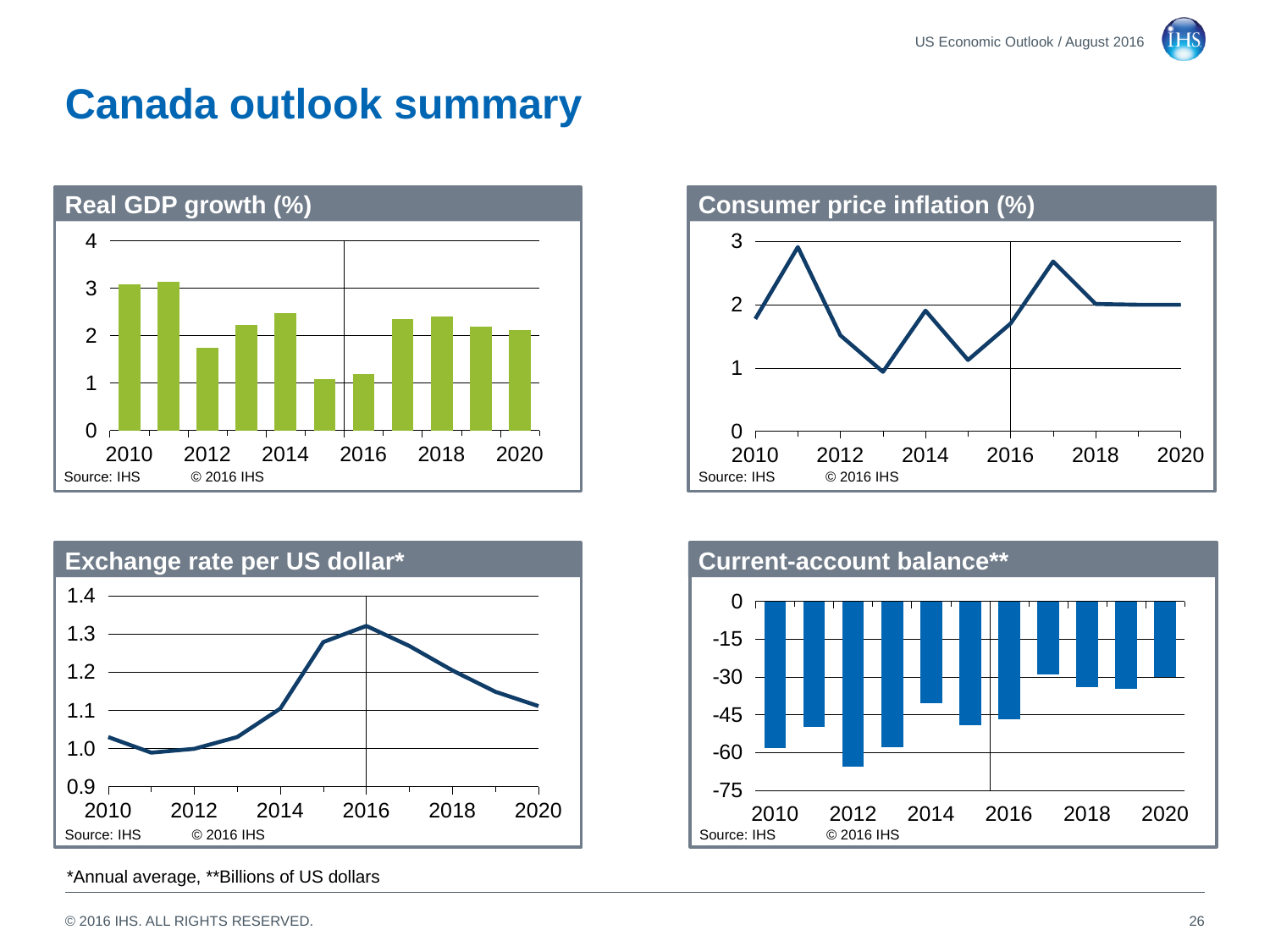
In the Exchange rate per US dollar* chart, which year has the highest value? 2016 In the Exchange rate per US dollar* chart, do values rise or fall from 2016 to 2020? fall In the Consumer price inflation (%) chart, which year has the highest value? 2011 In the Consumer price inflation (%) chart, which year has the lowest value? 2013 In the Real GDP growth (%) chart, is the value for 2014 greater or less than 2? greater How many bars are plotted in the Real GDP growth (%) chart? 11 What kind of chart is the Real GDP growth (%) chart? bar chart In the Current-account balance** chart, which year has the lowest (most negative) value? 2012 What kind of chart is the Consumer price inflation (%) chart? line chart In the Consumer price inflation (%) chart, is the value for 2017 greater or less than 2? greater How many charts are shown on the slide? 4 In the Real GDP growth (%) chart, is the value for 2012 greater or less than 2? less